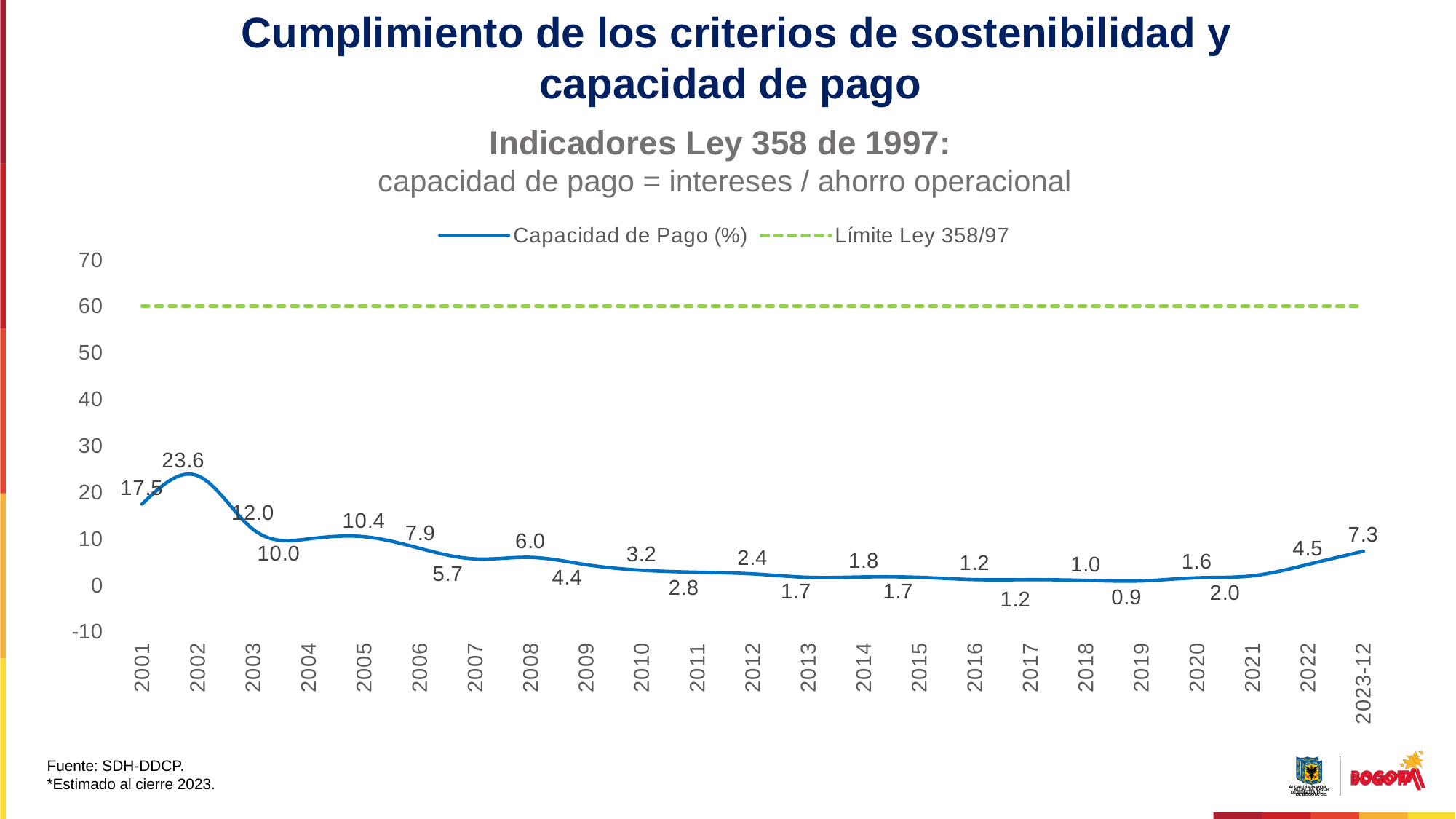
Is the Límite Ley 358/97 line greater or less than 50? greater Which year has the lowest Capacidad de Pago (%) value? 2019 Which is larger, the Capacidad de Pago (%) value for 2022 or for 2021? 2022 Does the Capacidad de Pago (%) value rise or fall from 2002 to 2019? fall What is the Capacidad de Pago (%) value for 2019? 0.9 What kind of chart is shown on the slide? line chart How many years are shown on the x axis? 23 What is the Capacidad de Pago (%) value for 2023-12? 7.3 How many series does the legend list? 2 Which year has the highest Capacidad de Pago (%) value? 2002 What is the difference between the Capacidad de Pago (%) values for 2002 and 2001? 6.1 What is the Capacidad de Pago (%) value for 2002? 23.6